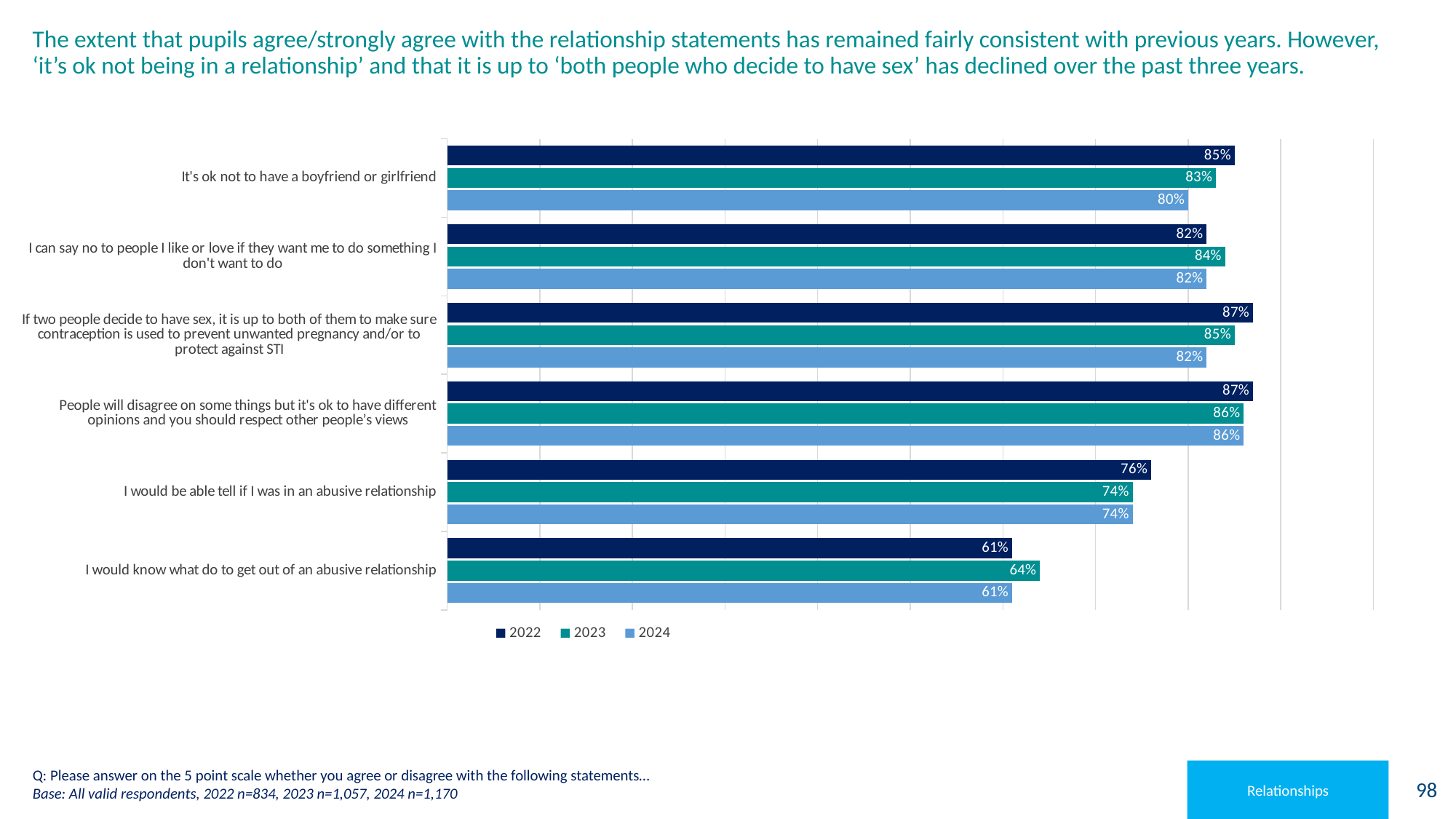
By how many percentage points did agreement with 'It's ok not to have a boyfriend or girlfriend' fall from 2022 to 2024? 5 What is the difference between the 2023 and 2022 values for 'I can say no to people I like or love if they want me to do something I don't want to do'? 2 percentage points What was the 2023 value for 'I would know what do to get out of an abusive relationship'? 64% Which statement has the highest agreement in 2024? People will disagree on some things but it's ok to have different opinions and you should respect other people's views Which statement has the lowest agreement in 2024? I would know what do to get out of an abusive relationship What type of chart is shown on the slide? Bar chart Which years are listed in the chart legend? 2022, 2023, 2024 What was the 2022 value for 'I would be able tell if I was in an abusive relationship'? 76% How many relationship statements are shown in the chart? 6 What percentage of pupils agreed with 'It's ok not to have a boyfriend or girlfriend' in 2024? 80% How many series does the legend list? 3 For 'If two people decide to have sex, it is up to both of them to make sure contraception is used...', which year had the higher value, 2022 or 2024? 2022